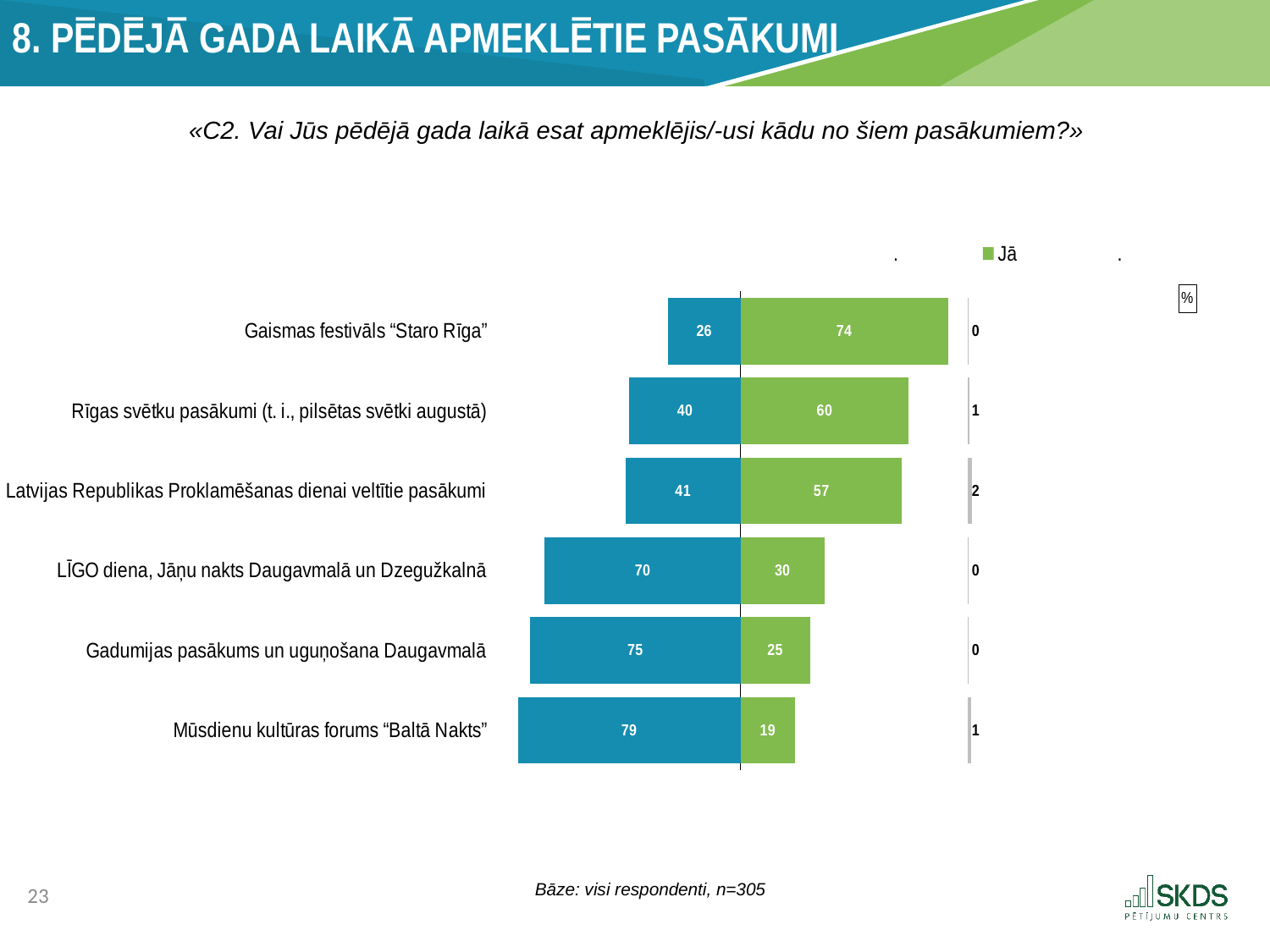
What is the value of the blue bar for LĪGO diena, Jāņu nakts Daugavmalā un Dzegužkalnā? 70 What is the value of the blue bar for Rīgas svētku pasākumi (t. i., pilsētas svētki augustā)? 40 What is the "Jā" value for Mūsdienu kultūras forums "Baltā Nakts"? 19 Which is larger: the "Jā" value for Latvijas Republikas Proklamēšanas dienai veltītie pasākumi or for LĪGO diena, Jāņu nakts Daugavmalā un Dzegužkalnā? Latvijas Republikas Proklamēšanas dienai veltītie pasākumi Which event has the highest "Jā" value? Gaismas festivāls "Staro Rīga" What kind of chart is shown on the slide? Bar chart How many events are listed in the chart? 6 What is the total of the blue and green segments for Gaismas festivāls "Staro Rīga"? 100 What is the "Jā" value for Gaismas festivāls "Staro Rīga"? 74 What colour represents the "Jā" series in the chart? Green Which event has the lowest "Jā" value? Mūsdienu kultūras forums "Baltā Nakts" What is the difference between the "Jā" values for Rīgas svētku pasākumi and Gadumijas pasākums un uguņošana Daugavmalā? 35